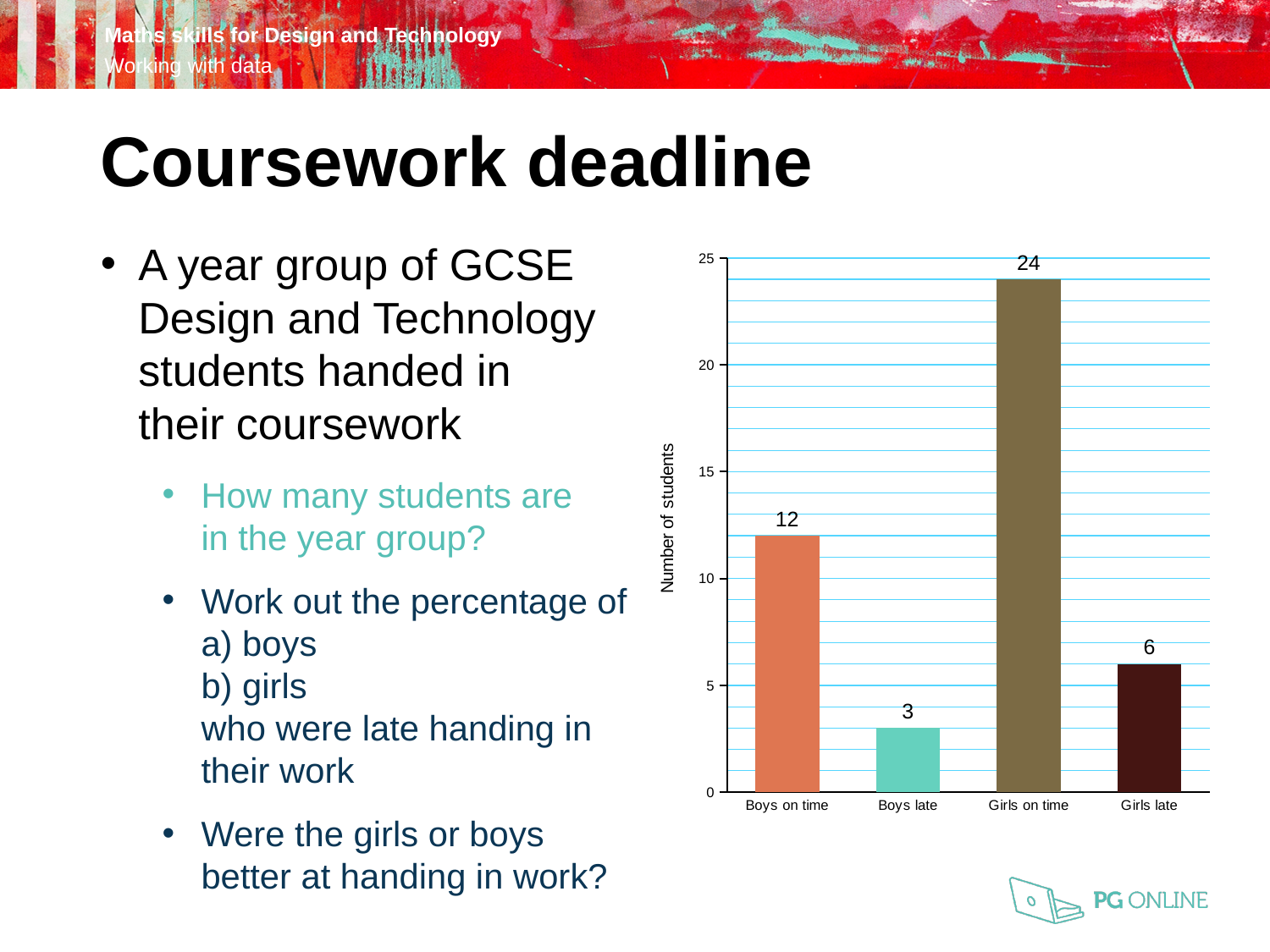
What is the difference between Girls on time and Boys on time? 12 Which is larger, Boys on time or Girls late? Boys on time Which category has the lowest number of students? Boys late What is the value for Boys late? 3 What is the value for Girls late? 6 What is the value for Girls on time? 24 What kind of chart is shown on the slide? Bar chart What is the label on the vertical axis of the chart? Number of students What is the difference between Girls late and Boys late? 3 Which category has the highest number of students? Girls on time What is the value for Boys on time? 12 How many categories are shown on the x axis? 4